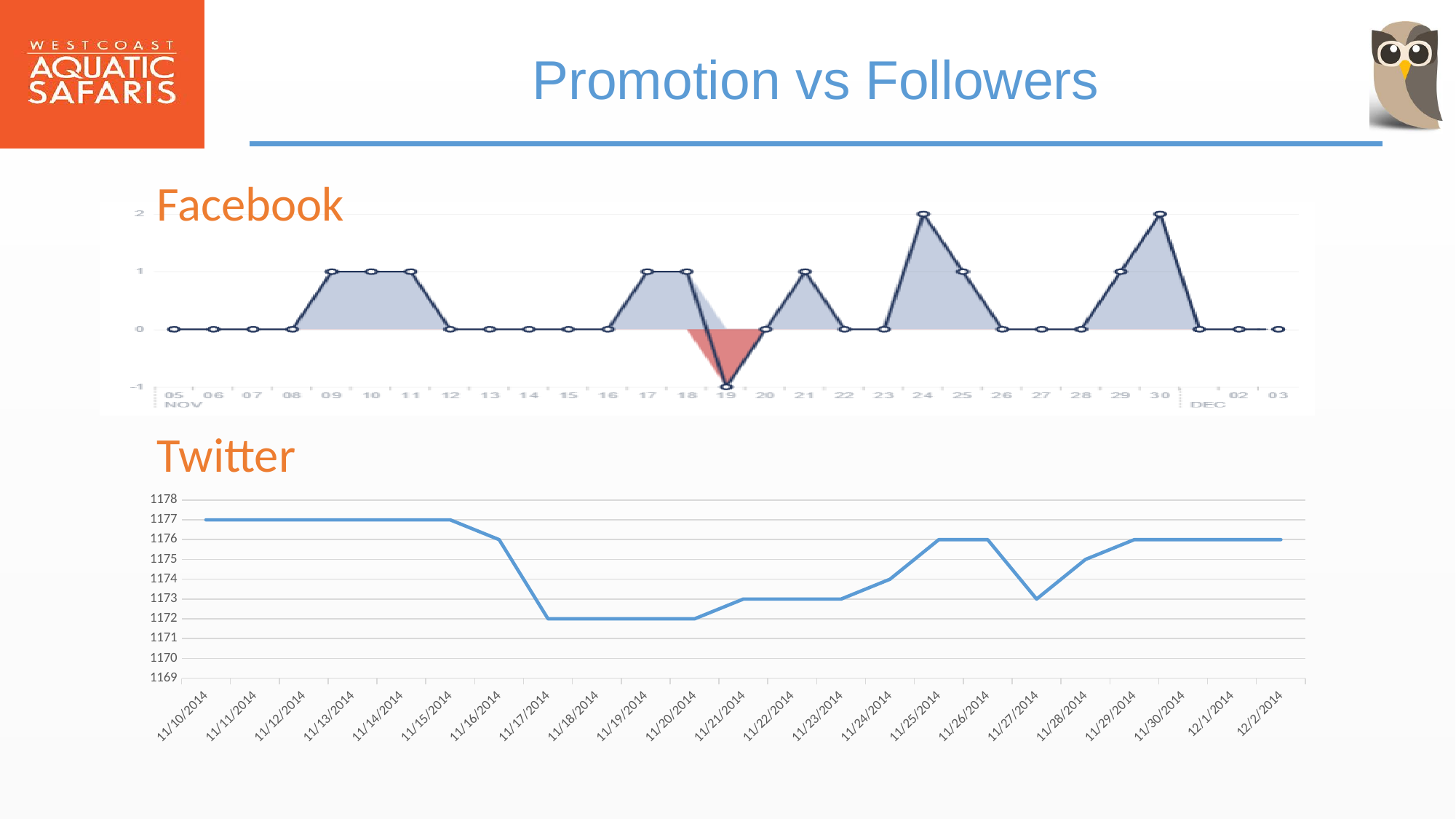
On the Twitter chart, does the value rise or fall from 11/15/2014 to 11/17/2014? fall On the Twitter chart, which is larger, the value on 11/24/2014 or the value on 11/25/2014? 11/25/2014 On the Twitter chart, what is the value on 12/2/2014? 1176 On the Facebook chart, what is the value on Nov 19? -1 On the Twitter chart, what is the value on 11/10/2014? 1177 On the Twitter chart, how many dates are shown on the x axis? 23 On the Twitter chart, what is the difference between the values on 11/10/2014 and 11/17/2014? 5 What kind of chart is the Twitter chart? line chart On the Facebook chart, what is the value on Nov 24? 2 On the Facebook chart, which date has the lowest value? Nov 19 On the Twitter chart, what is the value on 11/27/2014? 1173 On the Twitter chart, what is the value on 11/17/2014? 1172